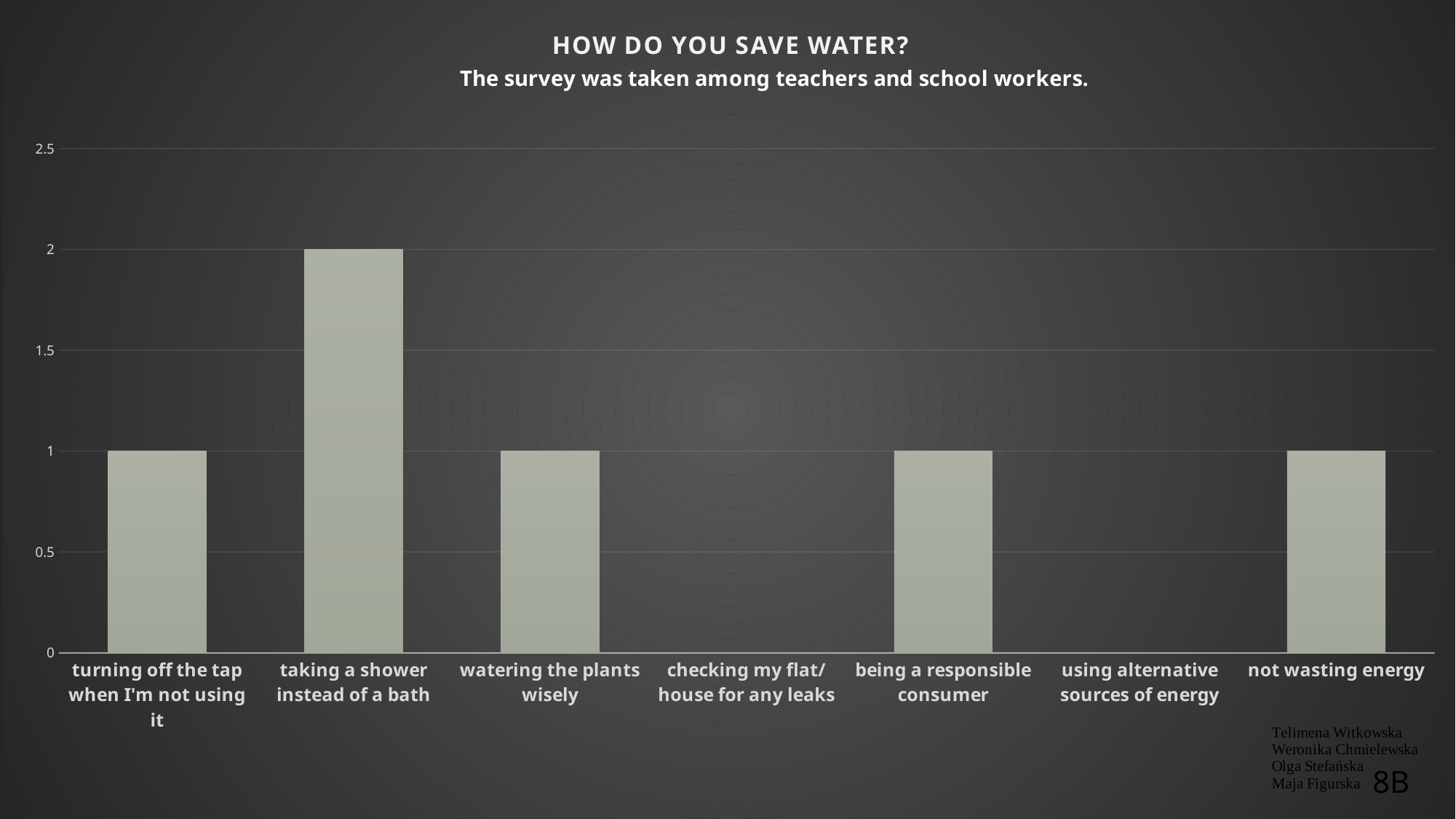
What kind of chart is shown on the slide? bar chart According to the subtitle, among whom was the survey taken? teachers and school workers What is the value for "turning off the tap when I'm not using it"? 1 Is the value for "taking a shower instead of a bath" greater or less than 1.5? greater What is the difference between the values for "taking a shower instead of a bath" and "watering the plants wisely"? 1 Which category has the highest value? taking a shower instead of a bath What is the value for "checking my flat/house for any leaks"? 0 What is the value for "taking a shower instead of a bath"? 2 What is the value for "not wasting energy"? 1 What is the title of the chart? HOW DO YOU SAVE WATER? Which is larger, the value for "being a responsible consumer" or the value for "using alternative sources of energy"? being a responsible consumer How many categories are shown on the x axis of the chart? 7